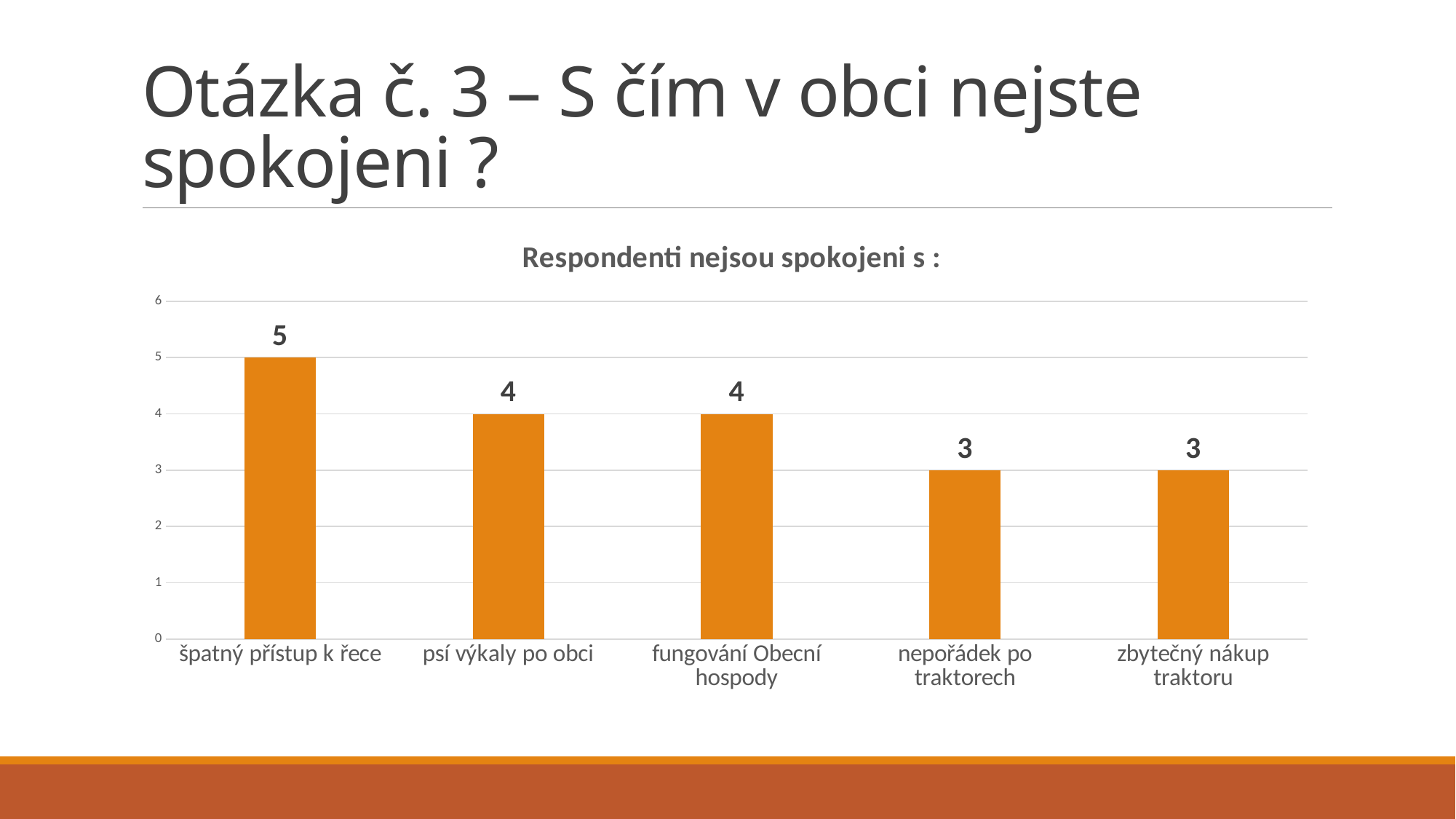
What is the title of the chart? Respondenti nejsou spokojeni s : What is the value for 'špatný přístup k řece'? 5 What is the value for 'nepořádek po traktorech'? 3 Which category has the highest value? špatný přístup k řece Which is larger, the value for 'psí výkaly po obci' or the value for 'zbytečný nákup traktoru'? psí výkaly po obci What colour are the bars in the chart? orange What is the value for 'zbytečný nákup traktoru'? 3 What is the value for 'psí výkaly po obci'? 4 How many categories are shown in the chart? 5 What is the difference between the values for 'špatný přístup k řece' and 'fungování Obecní hospody'? 1 Do the values rise or fall from left to right along the x axis? fall What kind of chart is shown on the slide? bar chart